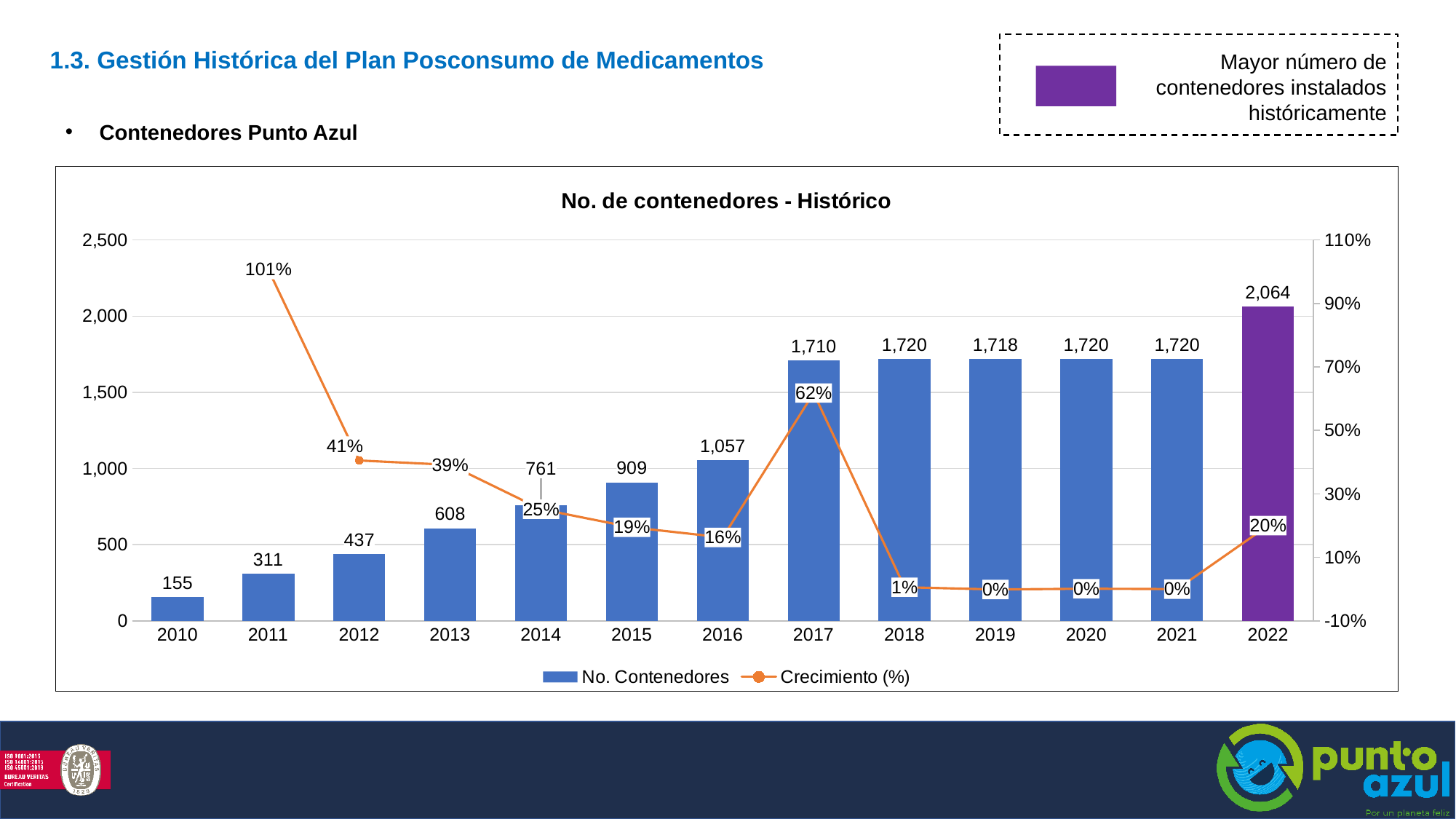
What is the growth (Crecimiento) percentage shown for 2017? 62% What is the difference in the number of containers between 2022 and 2021? 344 How many years are shown on the x axis? 13 What is the title of the chart? No. de contenedores - Histórico Which year has the highest growth percentage? 2011 What kind of chart is used for the No. Contenedores series? Bar chart What is the number of containers in 2010? 155 How many series does the legend list? 2 Which year has the lowest number of containers? 2010 Which is larger, the number of containers in 2016 or in 2015? 2016 What is the number of containers (No. Contenedores) in 2022? 2,064 Which year has the highest number of containers? 2022